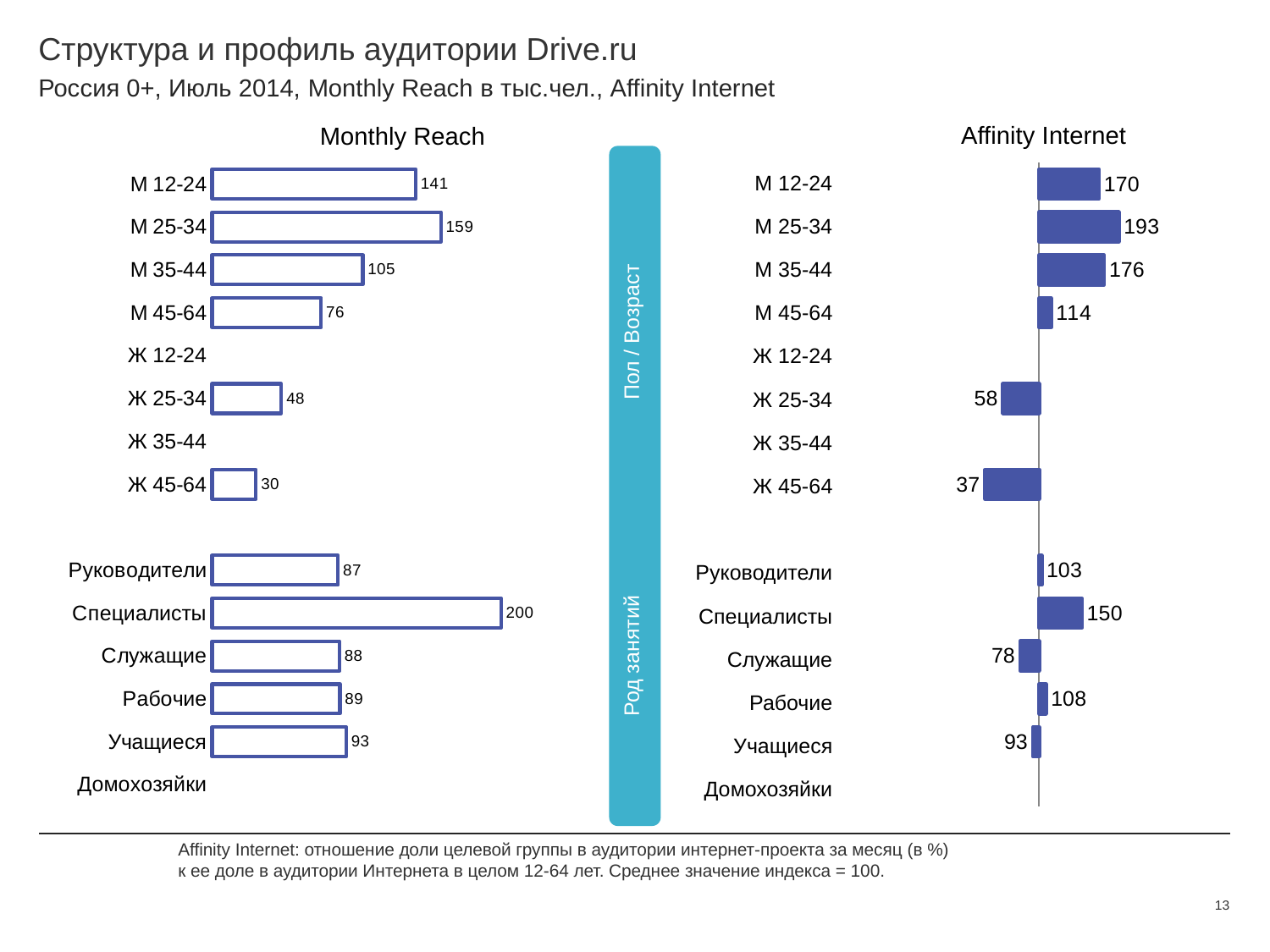
What kind of chart is the Monthly Reach chart? Bar chart In the Monthly Reach chart, which is larger, Учащиеся or Руководители? Учащиеся In the Affinity Internet chart, what is the value for Ж 45-64? 37 In the Monthly Reach chart, which labelled category has the lowest value? Ж 45-64 In the Affinity Internet chart, what is the difference between Специалисты and Служащие? 72 In the Monthly Reach chart, what is the difference between М 12-24 and М 45-64? 65 In the Monthly Reach chart, what is the value for Специалисты? 200 In the Monthly Reach chart, what is the value for М 25-34? 159 In the Affinity Internet chart, what is the value for М 35-44? 176 In the Affinity Internet chart, what is the value for Ж 25-34? 58 In the Affinity Internet chart, which is larger, Рабочие or Учащиеся? Рабочие In the Affinity Internet chart, which category has the highest value? М 25-34